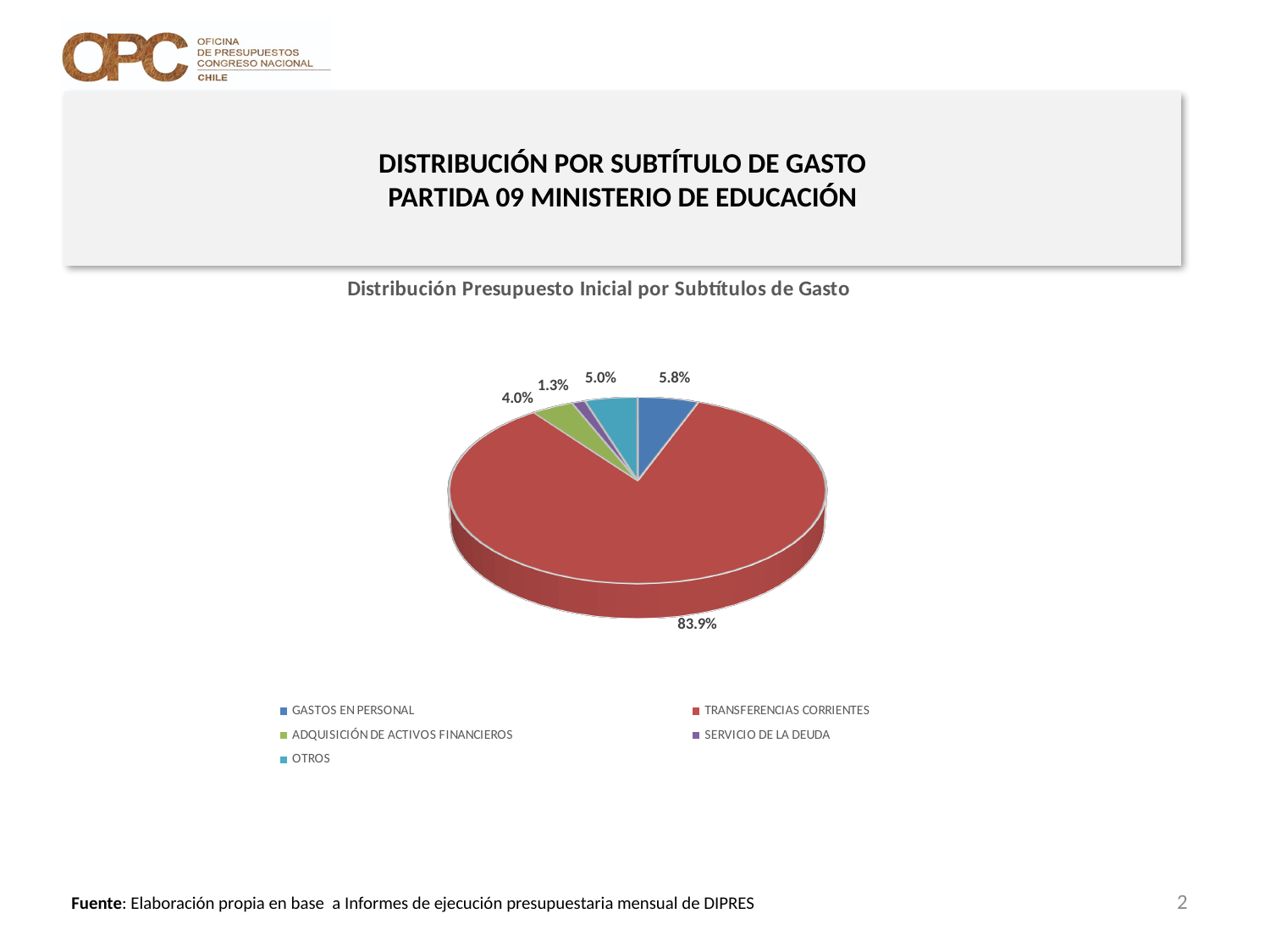
Which category has the smallest slice of the pie? SERVICIO DE LA DEUDA What share of the pie does TRANSFERENCIAS CORRIENTES represent? 83.9% What kind of chart is shown on the slide? pie chart What is the title of the chart? Distribución Presupuesto Inicial por Subtítulos de Gasto What is the difference between the share for GASTOS EN PERSONAL and the share for ADQUISICIÓN DE ACTIVOS FINANCIEROS? 1.8% What share of the pie does OTROS represent? 5.0% What share of the pie does ADQUISICIÓN DE ACTIVOS FINANCIEROS represent? 4.0% Which is larger, the share for GASTOS EN PERSONAL or the share for OTROS? GASTOS EN PERSONAL How many categories does the legend list? 5 Which category has the largest slice of the pie? TRANSFERENCIAS CORRIENTES